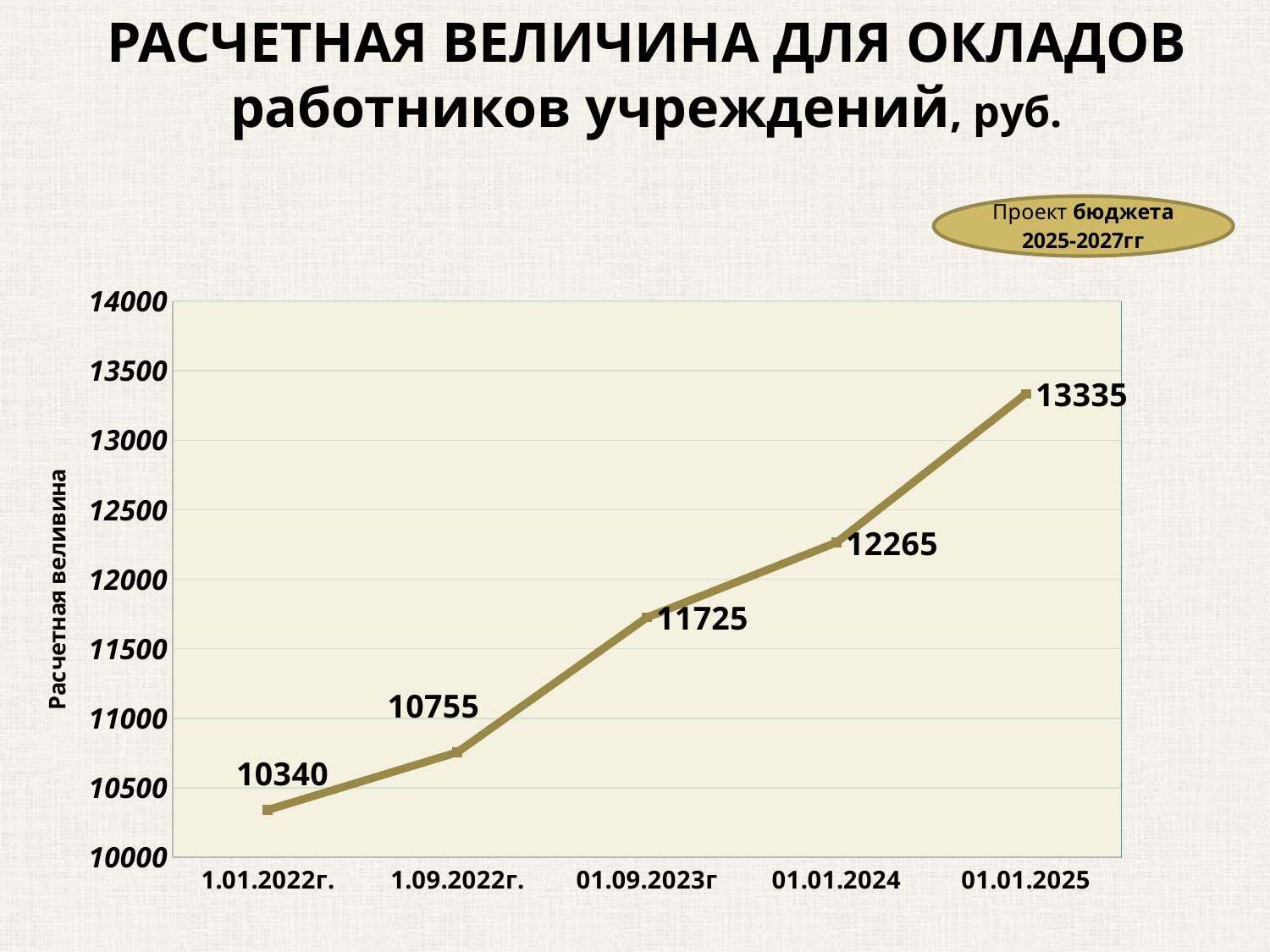
What is the value for 01.01.2025? 13335 What is the difference between the values for 1.09.2022г. and 1.01.2022г.? 415 Which is larger, the value for 01.01.2024 or the value for 01.09.2023г? 01.01.2024 How many data points are plotted on the chart? 5 What is the value for 01.09.2023г? 11725 What is the value for 1.01.2022г.? 10340 Which date has the lowest value? 1.01.2022г. Is the value for 01.01.2024 greater or less than 12000? greater Which date has the highest value? 01.01.2025 What kind of chart is shown on the slide? line chart What is the difference between the values for 01.01.2025 and 01.01.2024? 1070 Do the values rise or fall from 1.01.2022г. to 01.01.2025? rise